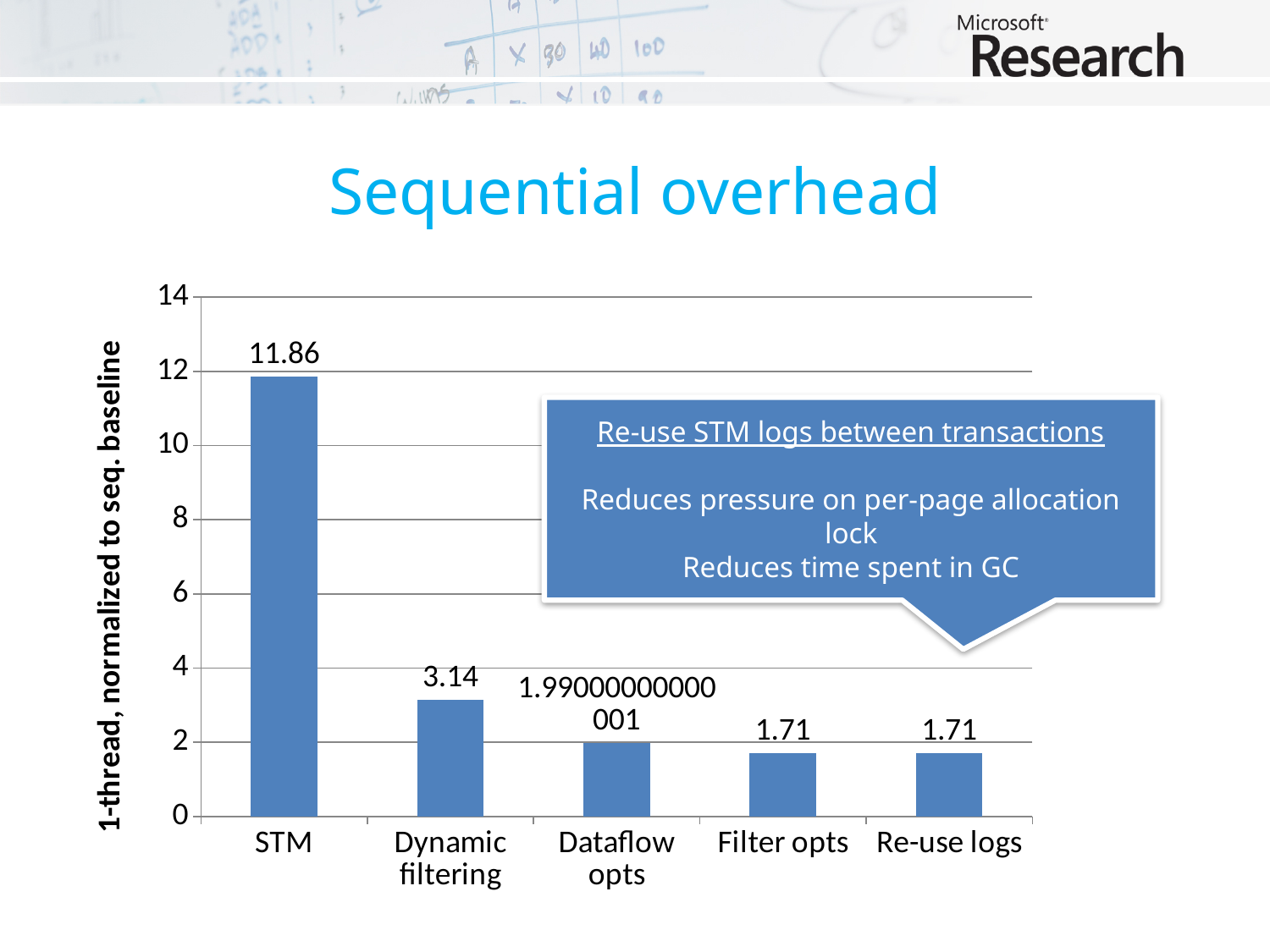
How many categories are shown on the x axis? 5 Which is larger, the value for Dynamic filtering or the value for Dataflow opts? Dynamic filtering Is the value for STM greater or less than 10? greater What is the value for Dynamic filtering? 3.14 What is the label of the vertical axis? 1-thread, normalized to seq. baseline What is the difference between the values for STM and Dynamic filtering? 8.72 What is the value for Filter opts? 1.71 What is the value for Re-use logs? 1.71 What kind of chart is shown on the slide? bar chart What is the value for STM? 11.86 What is the difference between the values for Dynamic filtering and Filter opts? 1.43 Which category has the highest value? STM